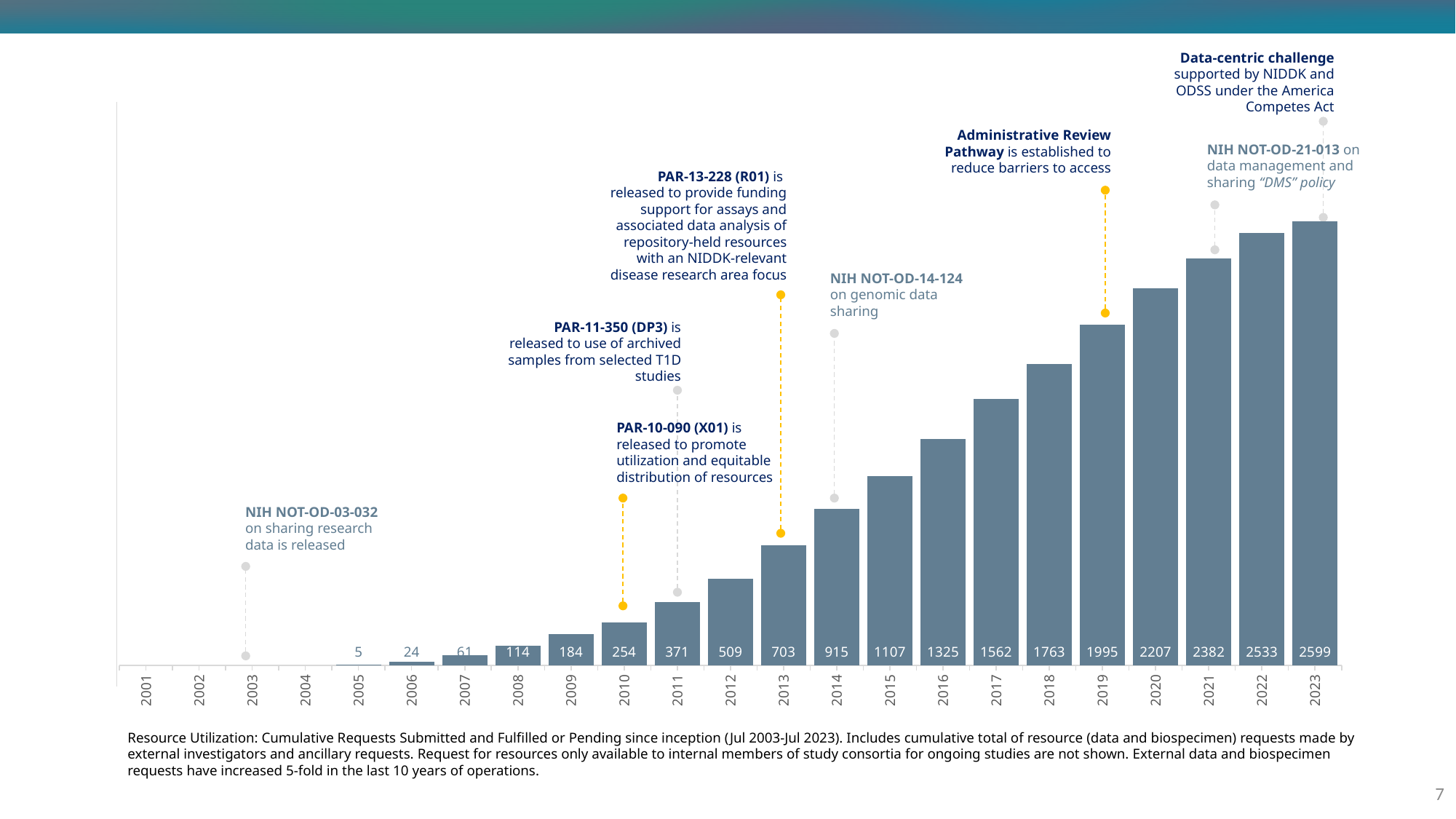
What is the difference between the values for 2023 and 2022? 66 How many years are shown on the x axis? 23 What is the difference between the values for 2014 and 2013? 212 Which year has the highest value in the chart? 2023 Which is larger, the value for 2016 or the value for 2017? 2017 What is the cumulative number of requests shown for 2013? 703 What type of chart is shown on the slide? bar chart Do the values rise or fall from 2005 to 2023? rise What value is shown for 2019? 1995 Which year has the lowest labeled value in the chart? 2005 Which year is annotated with 'NIH NOT-OD-14-124 on genomic data sharing'? 2014 What value is shown for 2008? 114